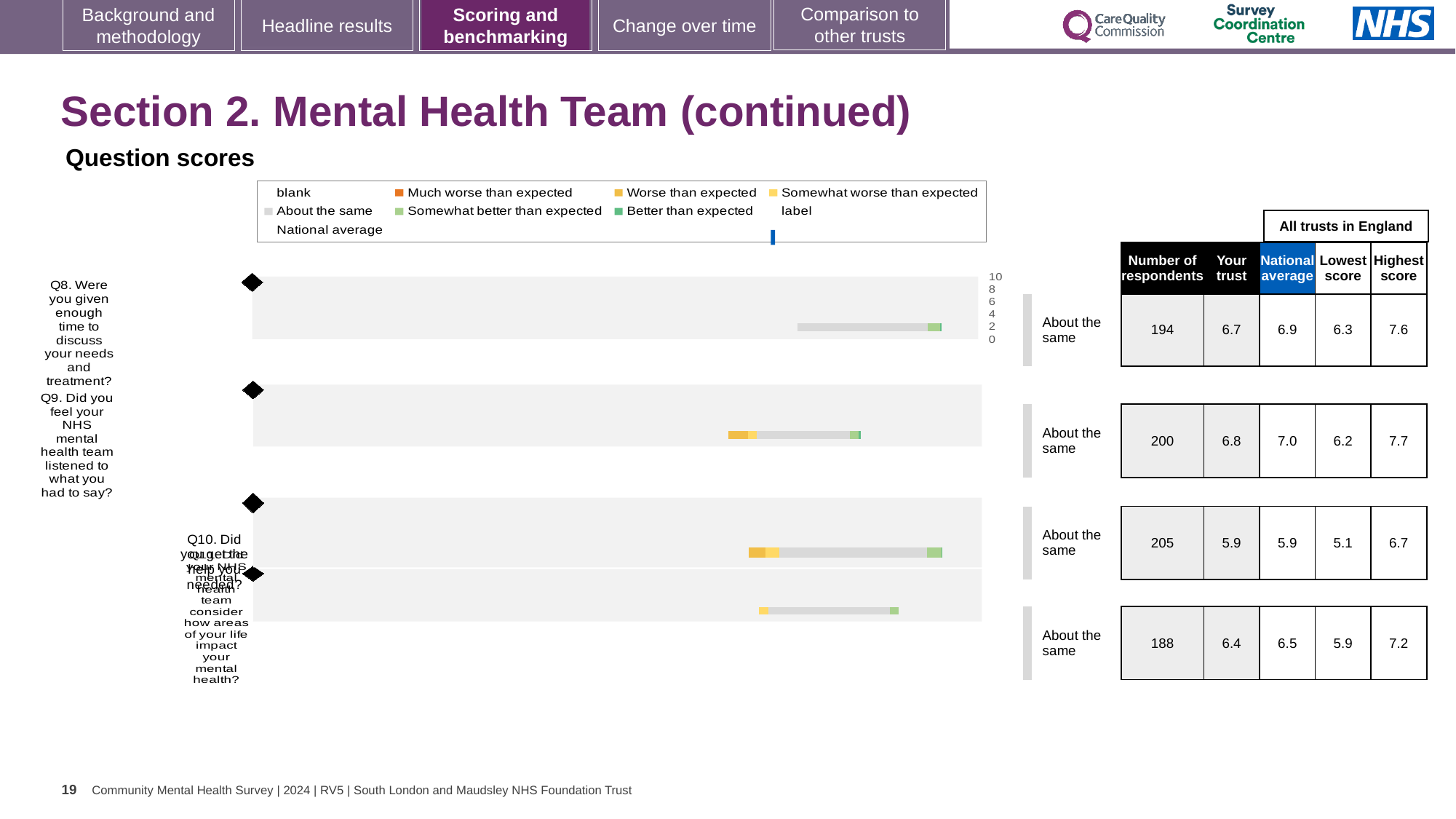
What benchmark category is shown for Q8 in the chart? About the same How many questions (rows) are plotted in the Question scores chart? 4 What kind of chart is shown under 'Question scores'? bar chart What is the difference between the highest score and the lowest score for Q9? 1.5 In the legend, what colour represents 'Much worse than expected'? Orange What is the 'Your trust' score for Q9 (Did you feel your NHS mental health team listened to what you had to say?)? 6.8 What is the national average score for Q10 (Did you get the help you needed?)? 5.9 Which question has the highest number of respondents? Q10 What is the highest score among all trusts in England for Q9? 7.7 What is the number of respondents for Q8 (Were you given enough time to discuss your needs and treatment?)? 194 For Q8, which is larger: the 'Your trust' score or the national average? National average Which question has the lowest 'Your trust' score? Q10